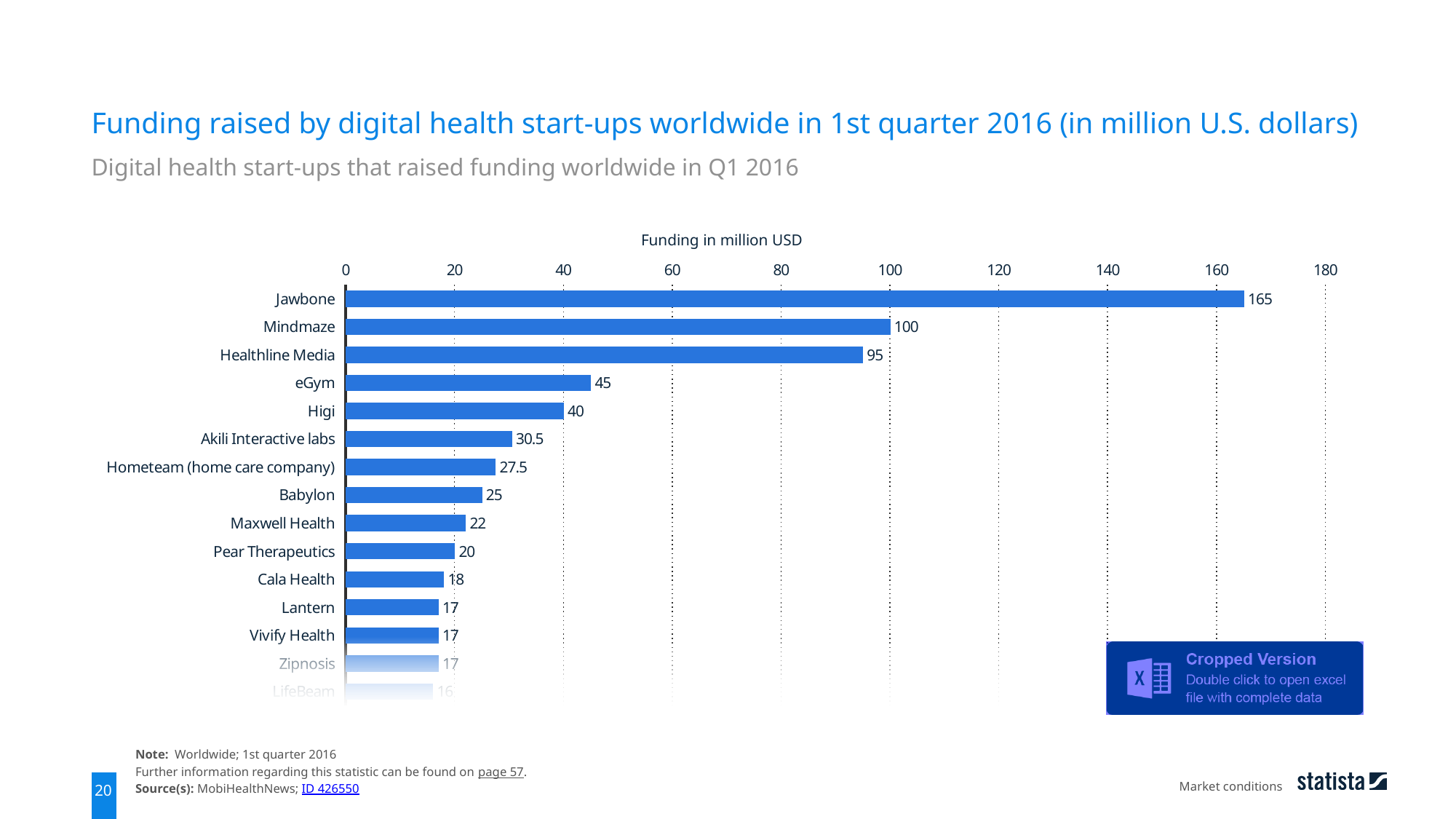
What is the funding raised by Hometeam (home care company)? 27.5 Which start-up raised the most funding? Jawbone What is the funding raised by Pear Therapeutics? 20 Is the value for Mindmaze greater or less than 80? greater What is the difference in funding between eGym and Higi? 5 What is the funding raised by Jawbone? 165 What is the funding raised by Healthline Media? 95 What is the funding raised by Akili Interactive labs? 30.5 What is the label of the x axis? Funding in million USD Which raised more funding, Babylon or Maxwell Health? Babylon What kind of chart is shown on the slide? Bar chart What is the difference in funding between Jawbone and Mindmaze? 65